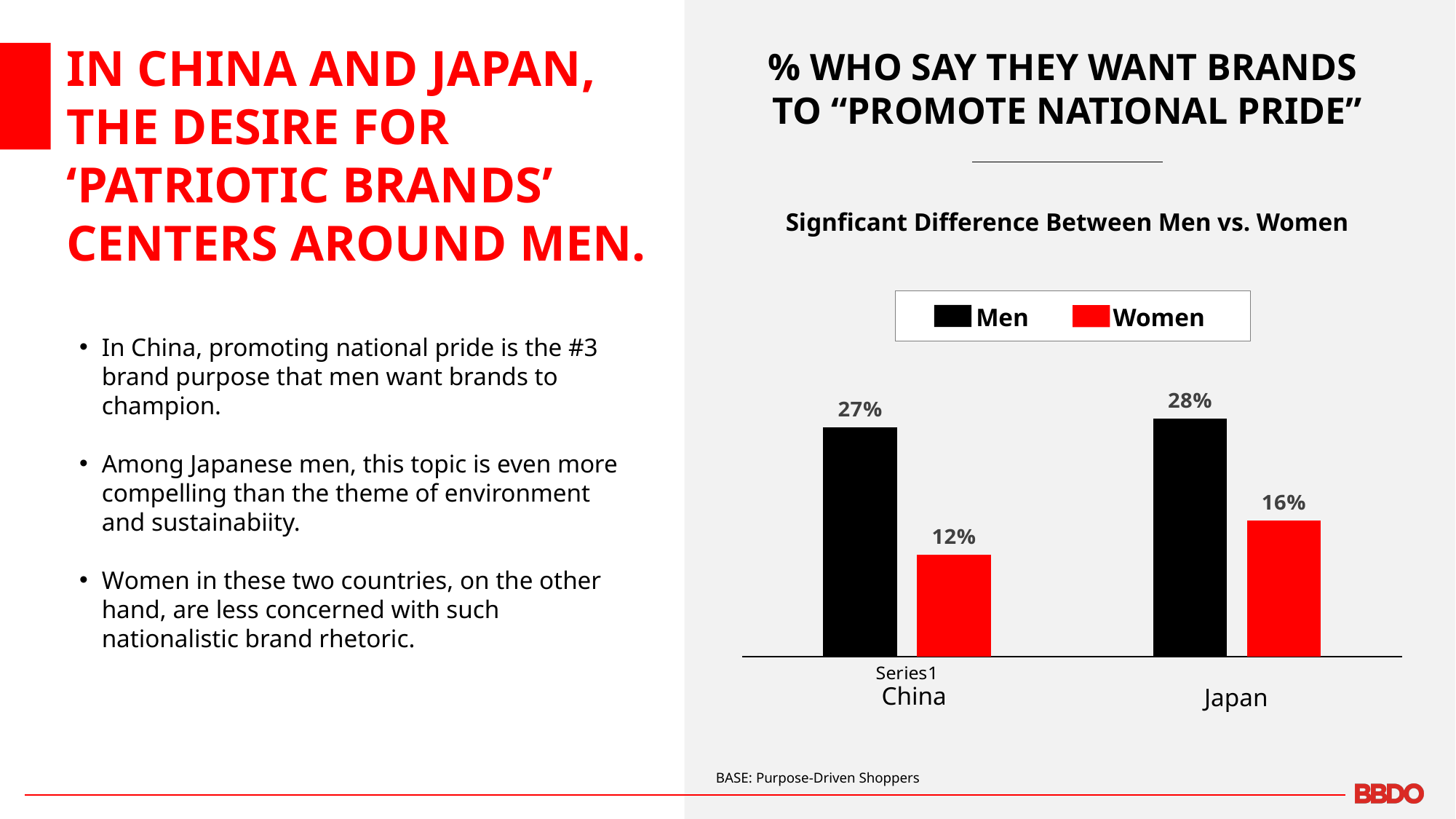
What kind of chart is shown on the slide? Bar chart Which group has the lowest value on the chart? Women in China What percentage of women in Japan say they want brands to promote national pride? 16% What percentage of men in China say they want brands to promote national pride? 27% Which is larger: the value for women in Japan or the value for women in China? Women in Japan What is the difference between men and women in Japan? 12% What colour represents Women in the chart? Red How many series does the legend list? 2 What is the difference between men and women in China? 15% What is the value for men in Japan? 28% What is the value for women in China? 12% How many countries are shown on the chart? 2